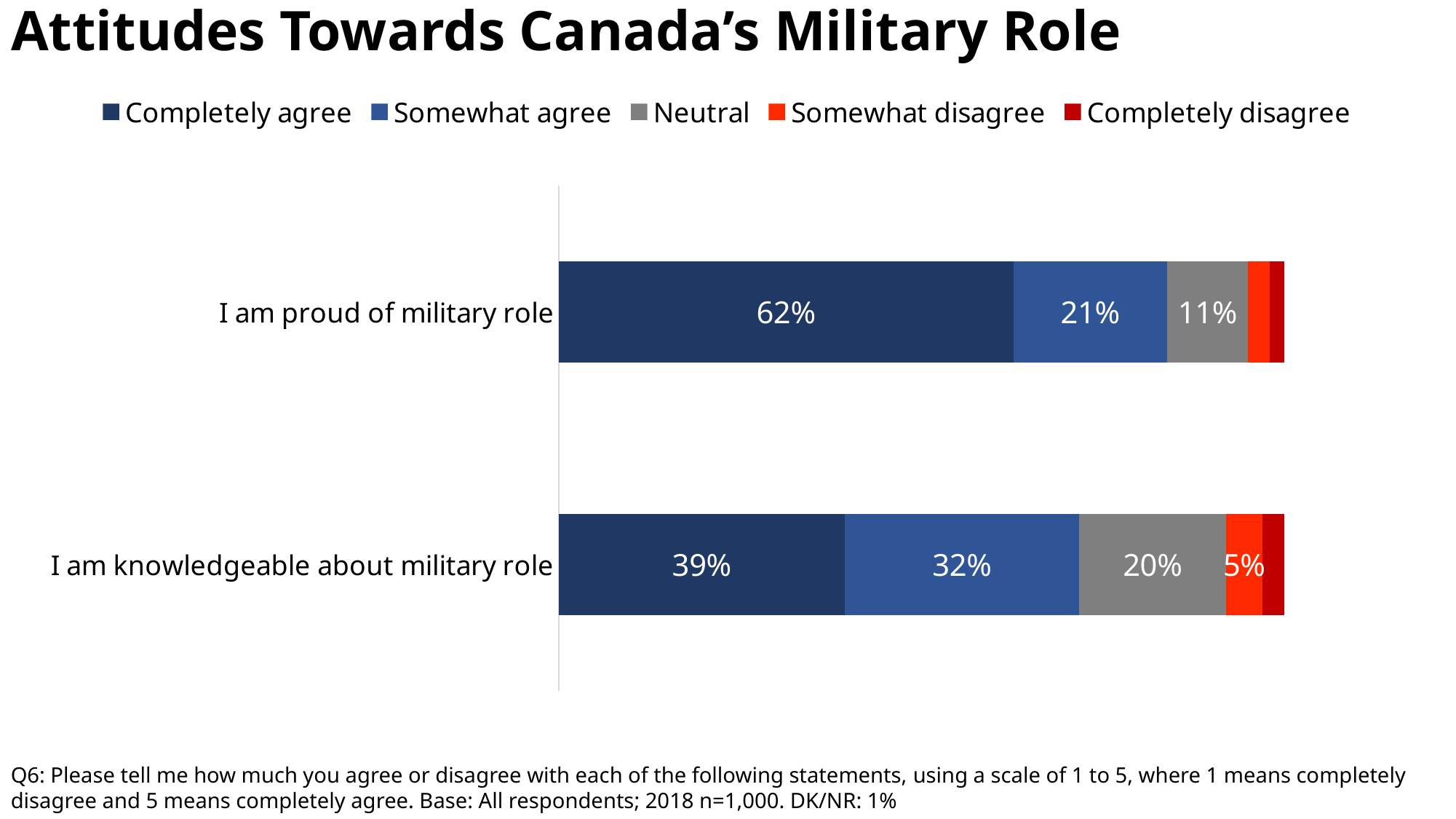
How many statements are shown in the chart? 2 What is the difference between the Neutral shares for the two statements? 9 percentage points What percentage of respondents completely agree with "I am proud of military role"? 62% What is the difference between the Completely agree shares for "I am proud of military role" and "I am knowledgeable about military role"? 23 percentage points Which statement has the higher Completely agree share? I am proud of military role What type of chart is shown on the slide? Stacked bar chart What is the Neutral share for "I am proud of military role"? 11% Which statement has the larger Somewhat agree share? I am knowledgeable about military role What is the Somewhat disagree share for "I am knowledgeable about military role"? 5% What percentage of respondents somewhat agree with "I am knowledgeable about military role"? 32% How many series does the legend list? 5 What is the Neutral share for "I am knowledgeable about military role"? 20%